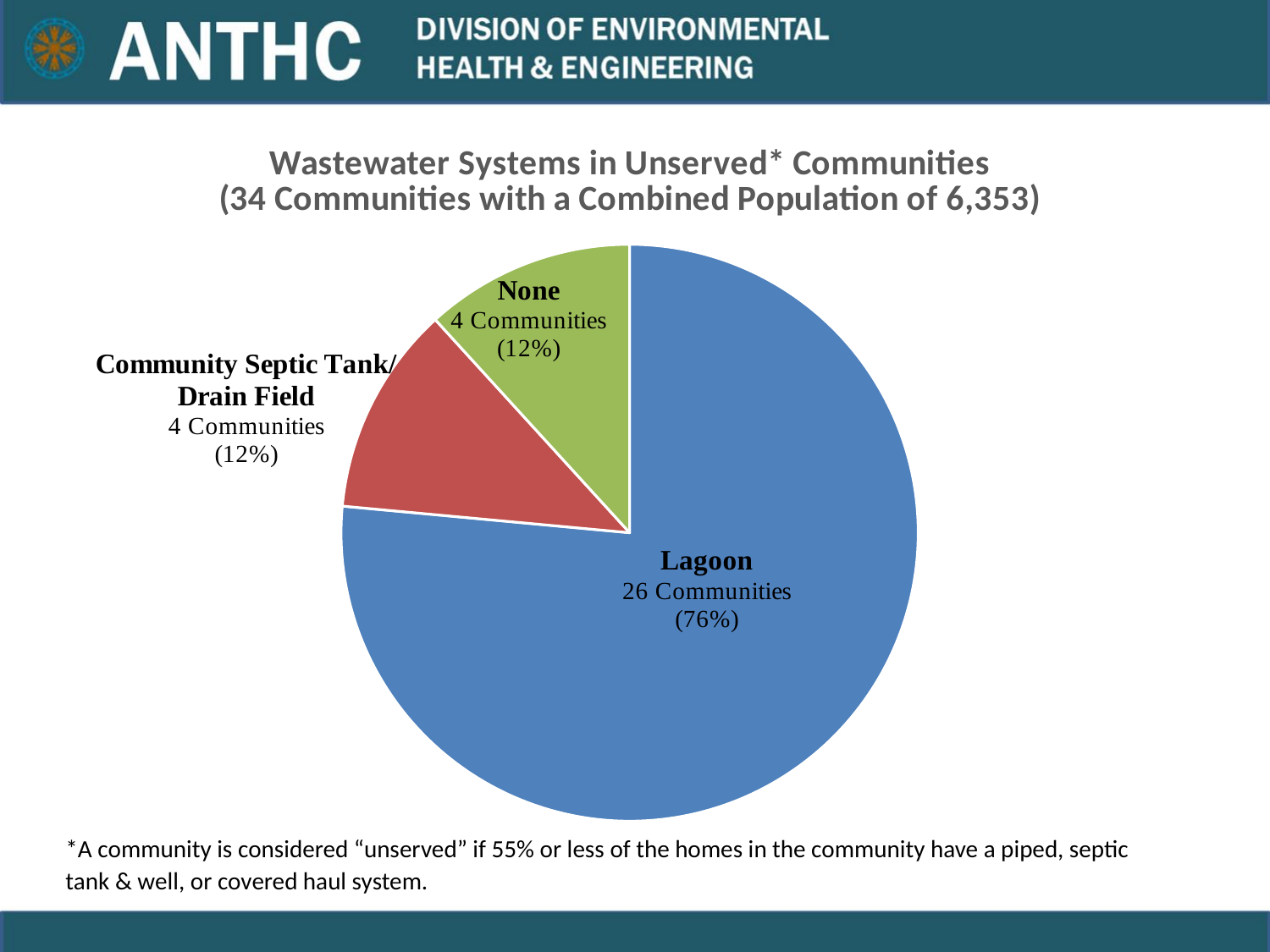
What is the difference in the number of communities between Lagoon and None? 22 What kind of chart is shown on the slide? pie chart How many categories are shown in the pie chart? 3 How many communities have no wastewater system (None)? 4 Communities Which is larger, the number of communities with a Lagoon or the number with a Community Septic Tank/Drain Field? Lagoon What colour is the Lagoon slice of the pie? blue What percentage of communities use a Community Septic Tank/Drain Field? 12% Which wastewater system category has the largest slice of the pie? Lagoon What is the total number of communities represented in the pie chart? 34 What is the title of the chart? Wastewater Systems in Unserved* Communities (34 Communities with a Combined Population of 6,353) What share of the pie does the Lagoon slice represent? 76% How many communities have a Lagoon wastewater system? 26 Communities